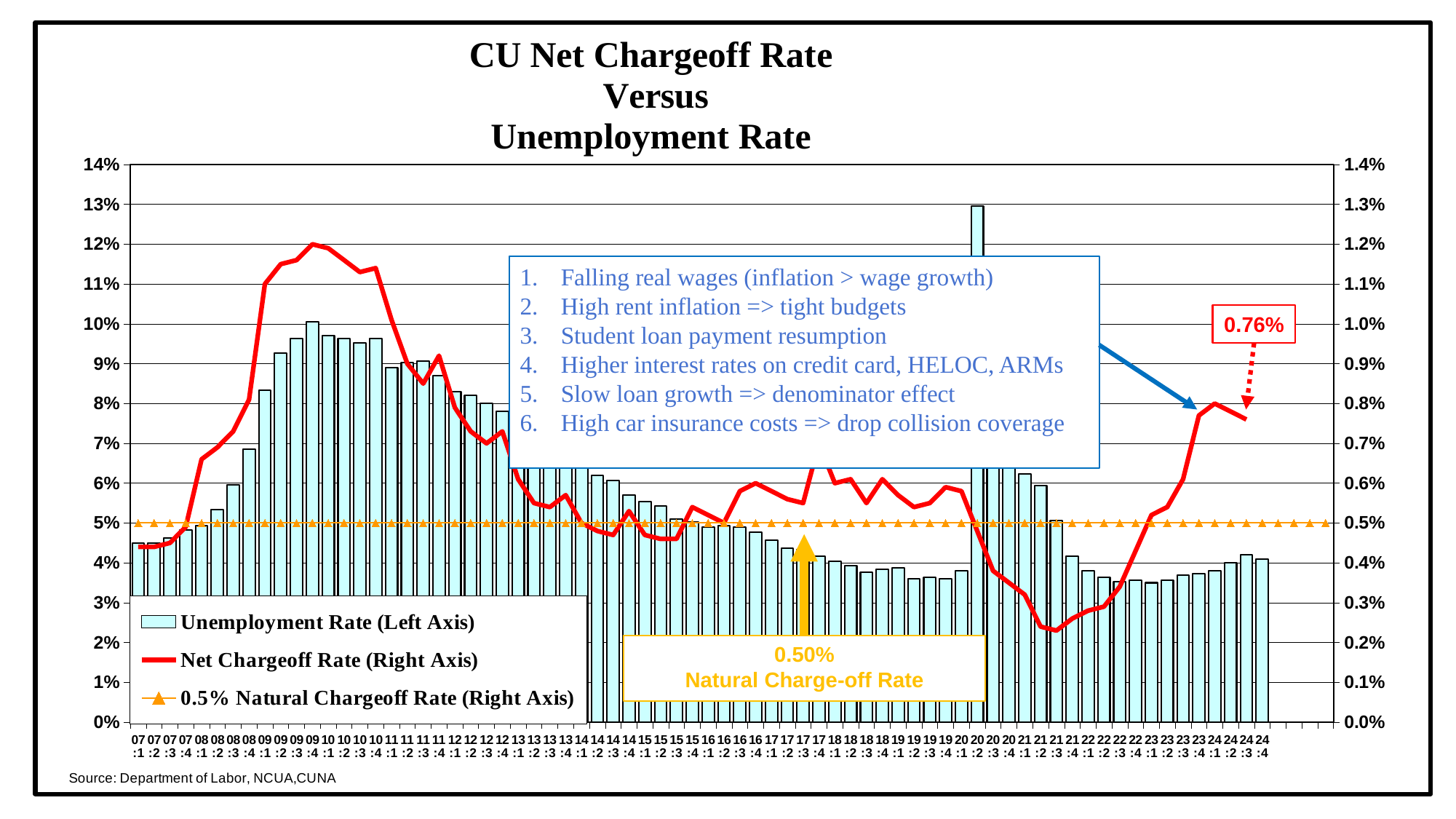
Is the Unemployment Rate for 09:4 greater or less than 9%? greater What is the title of the chart? CU Net Chargeoff Rate Versus Unemployment Rate Which is larger, the Net Chargeoff Rate in 09:4 or in 24:4? 09:4 Which quarter has the highest Unemployment Rate? 20:2 Is the Unemployment Rate for 20:2 greater or less than 12%? greater What value does the Natural Chargeoff Rate line sit at? 0.50% Is the Net Chargeoff Rate for 21:2 greater or less than 0.3%? less Does the Net Chargeoff Rate rise or fall from 21:2 to 23:4? rise What kind of chart is this? Combination bar and line chart How many series does the legend list? 3 Which series is plotted on the left axis? Unemployment Rate What is the Net Chargeoff Rate value called out by the red label at the right end of the chart? 0.76%